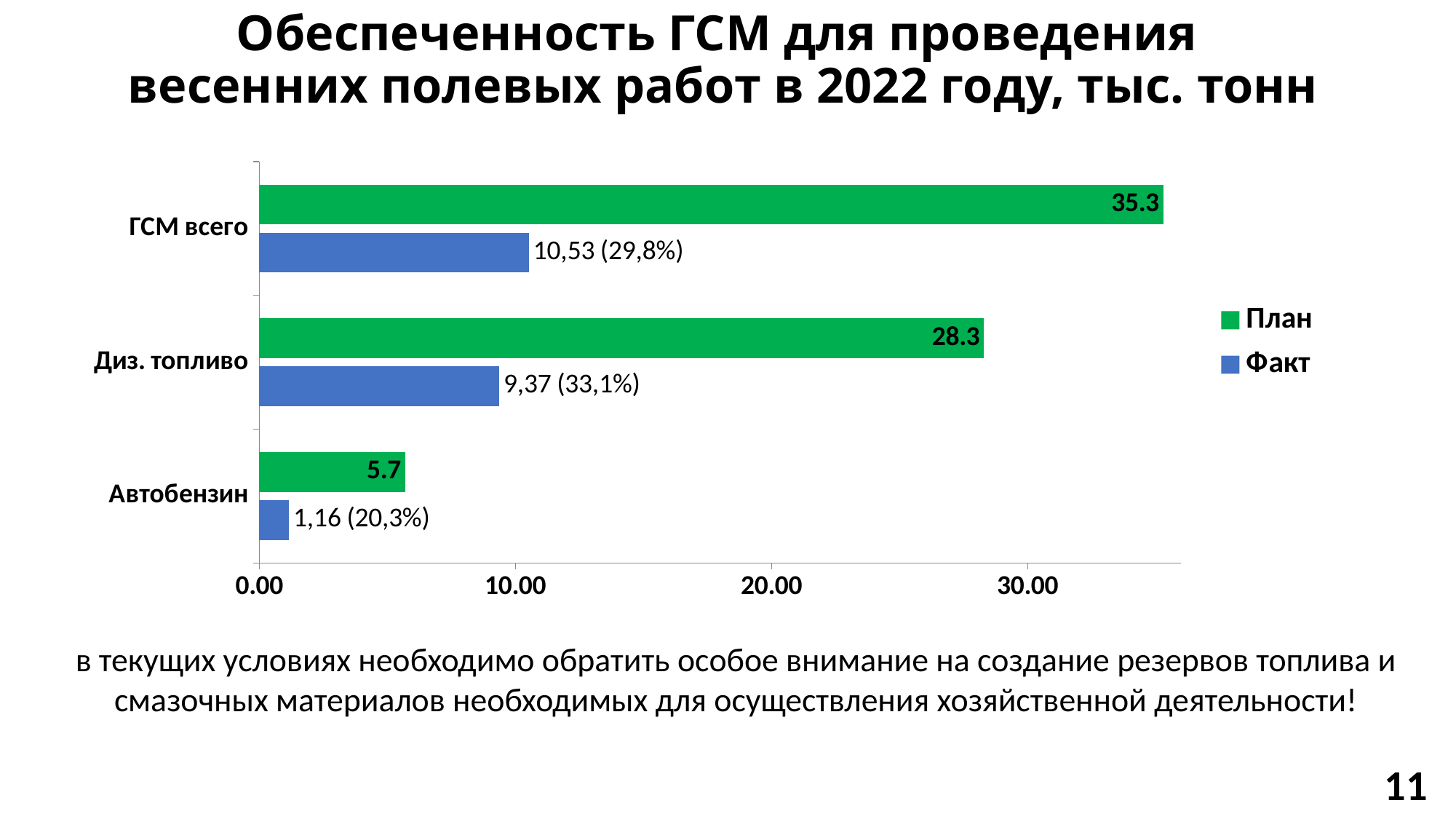
Is the Факт value for ГСМ всего greater or less than 20.00? less How many series does the legend list? 2 What is the План value for ГСМ всего? 35.3 Which is larger: the План value for Автобензин or the Факт value for Диз. топливо? Факт value for Диз. топливо What is the Факт value for Диз. топливо? 9,37 (33,1%) What type of chart is shown on the slide? bar chart Which category has the highest Факт value? ГСМ всего How many categories are shown on the chart? 3 What is the difference between the План values for ГСМ всего and Диз. топливо? 7.0 Which category has the lowest План value? Автобензин What is the План value for Диз. топливо? 28.3 What is the Факт value for Автобензин? 1,16 (20,3%)